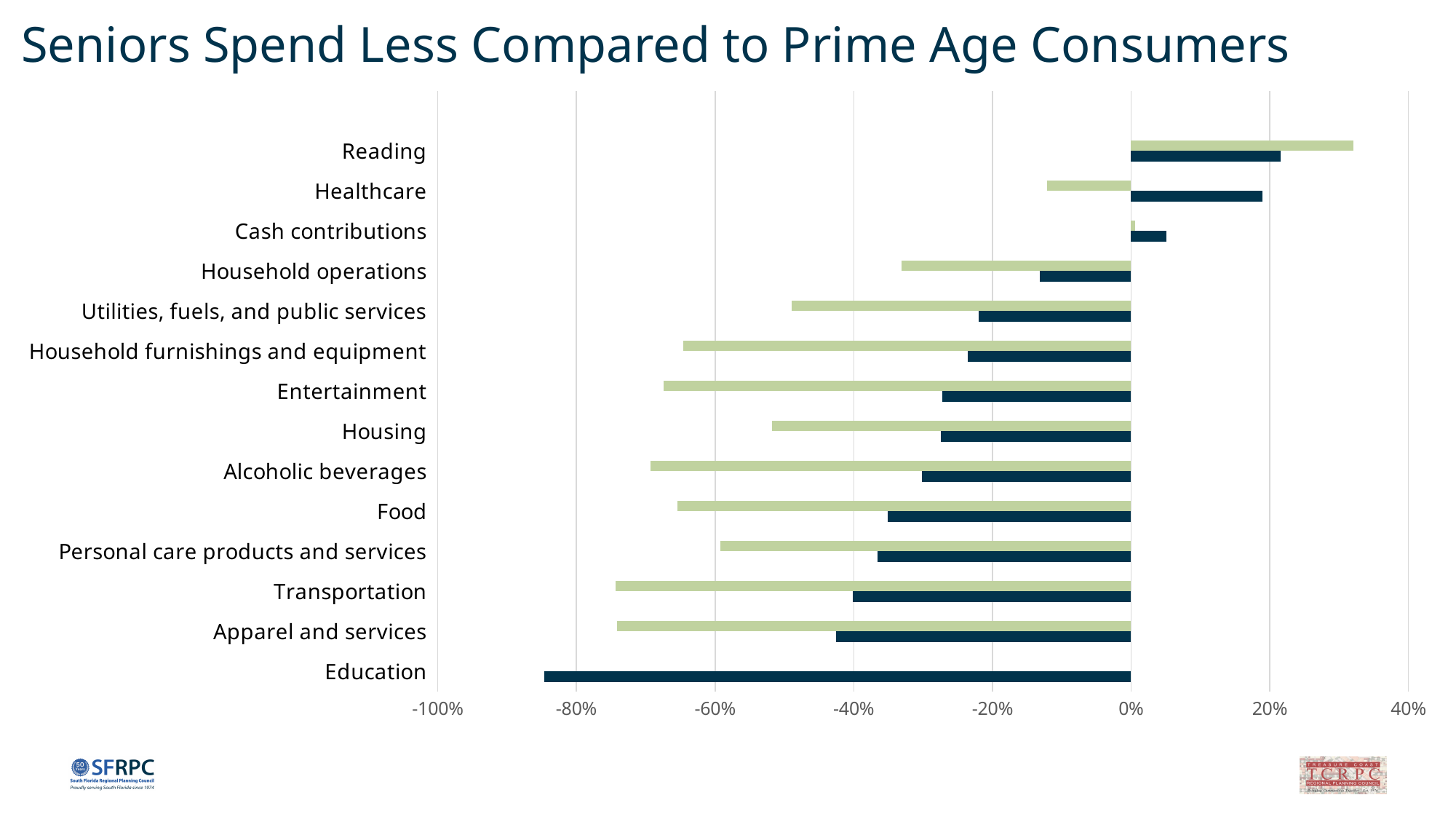
Which category shows only a dark blue bar and no light green bar? Education Is the light green bar for Housing greater or less than -40%? less Which category has the lowest value in the chart? Education Is the light green bar for Reading greater or less than 20%? greater How many categories are listed on the vertical axis of the chart? 14 Is the light green bar for Transportation greater or less than -60%? less What is the title of the chart slide? Seniors Spend Less Compared to Prime Age Consumers Which category has the highest value in the chart? Reading Which is larger, the dark blue bar for Food or the dark blue bar for Transportation? Food What kind of chart is shown on the slide? bar chart